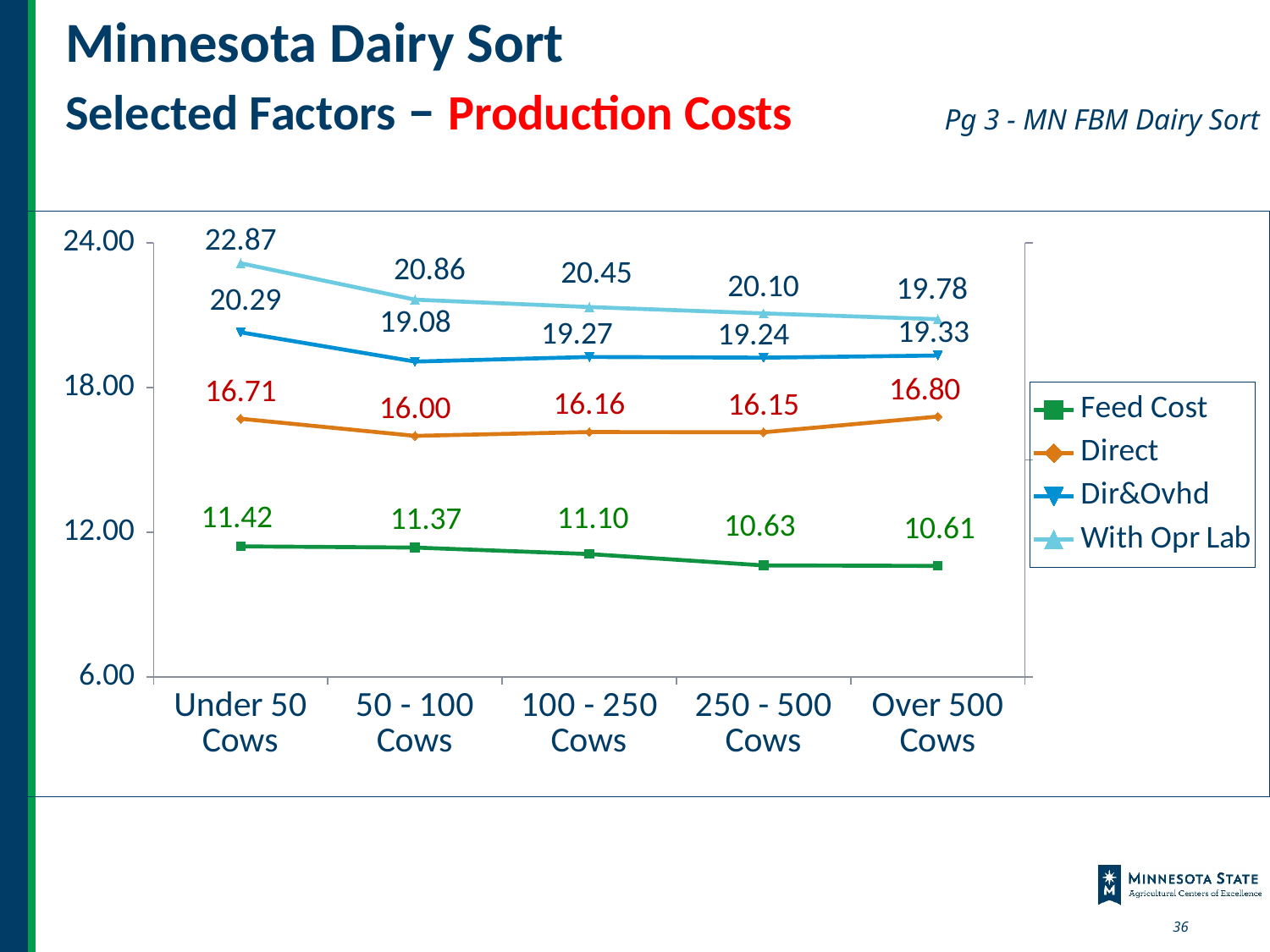
What is the Feed Cost value for the Under 50 Cows category? 11.42 Which category has the lowest Feed Cost value? Over 500 Cows How many series does the legend list? 4 What kind of chart is shown on the slide? line chart Does the Feed Cost series rise or fall from Under 50 Cows to Over 500 Cows? fall What is the difference between the With Opr Lab value and the Dir&Ovhd value for the Under 50 Cows category? 2.58 What is the Direct value for the Over 500 Cows category? 16.80 Which category has the highest With Opr Lab value? Under 50 Cows What is the Dir&Ovhd value for the 50 - 100 Cows category? 19.08 Is the Direct value for 250 - 500 Cows larger or smaller than the Direct value for Over 500 Cows? smaller How many categories are shown on the x axis? 5 What is the With Opr Lab value for the 100 - 250 Cows category? 20.45